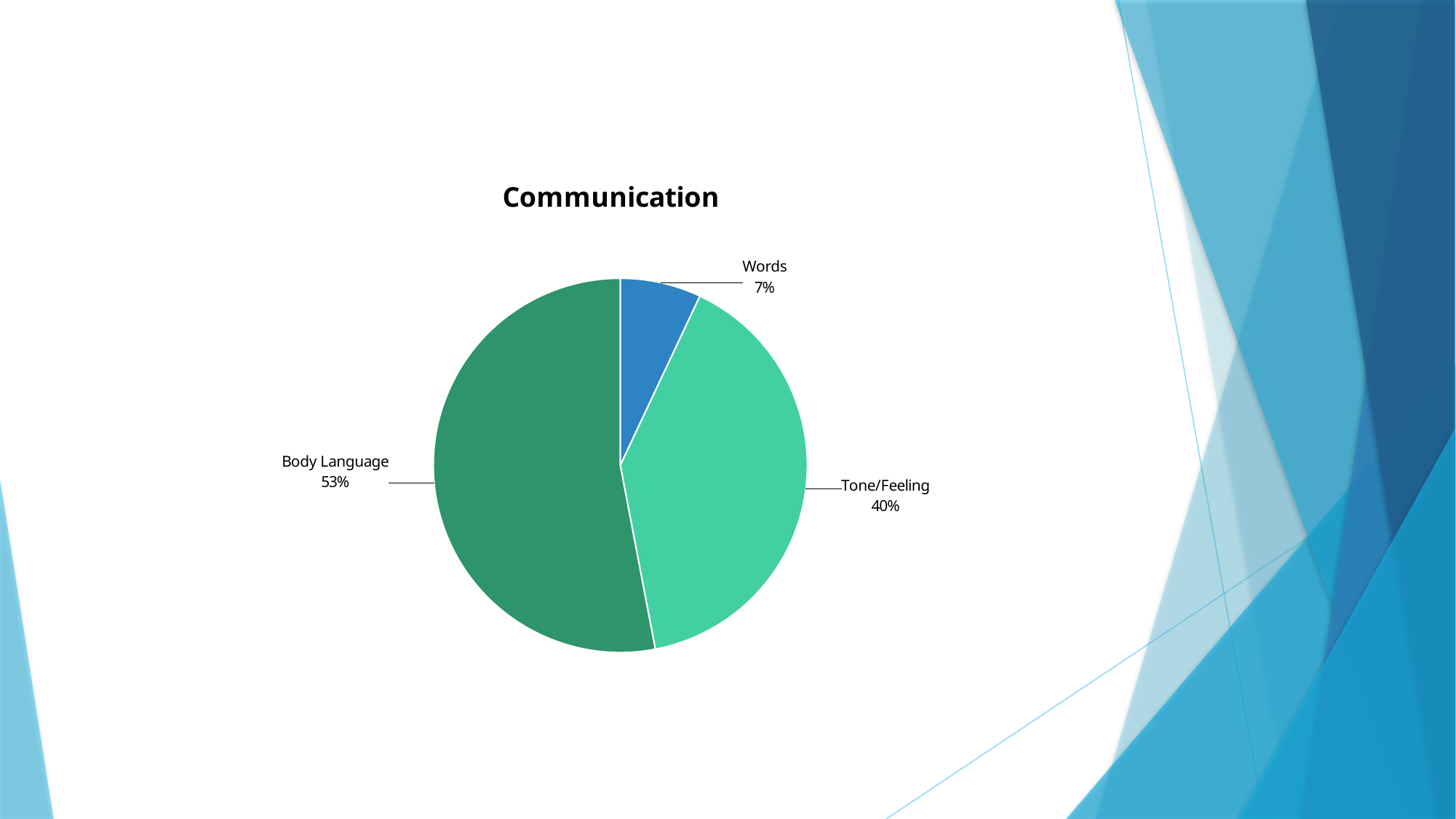
Which category has the smallest slice? Words What kind of chart is shown on the slide? pie chart What colour is the Words slice? blue What share of the pie does Body Language take? 53% How many slices does the pie chart have? 3 Which category has the largest slice? Body Language What is the difference between the Body Language and Tone/Feeling shares? 13% What is the title of the chart? Communication Which is larger, the Tone/Feeling slice or the Words slice? Tone/Feeling What share of the pie does Tone/Feeling take? 40% What share of the pie does Words take? 7% What is the difference between the Tone/Feeling and Words shares? 33%